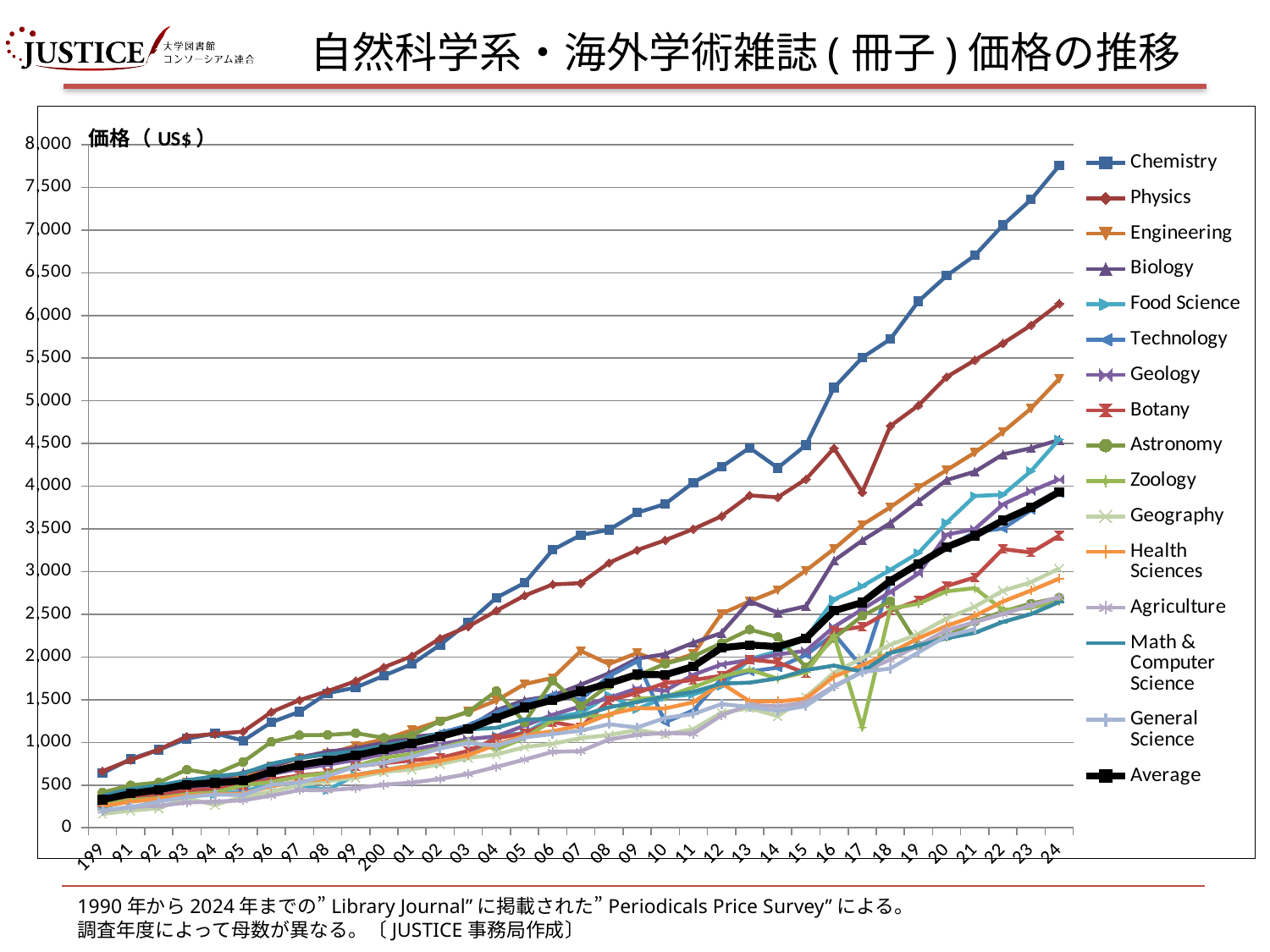
What label is shown on the vertical axis of the chart? 価格 (US$) Which is larger in 2024, Chemistry or Physics? Chemistry Is the value for Physics in 2024 greater or less than 5,500? greater Is the value for Chemistry in 2013 greater or less than 4,000? greater Is the value for Engineering in 2024 greater or less than 5,000? greater How many series does the legend list? 16 Which series has the highest value in 2024? Chemistry What kind of chart is shown on the slide? line chart Does the Chemistry series rise or fall from 1990 to 2024? rise